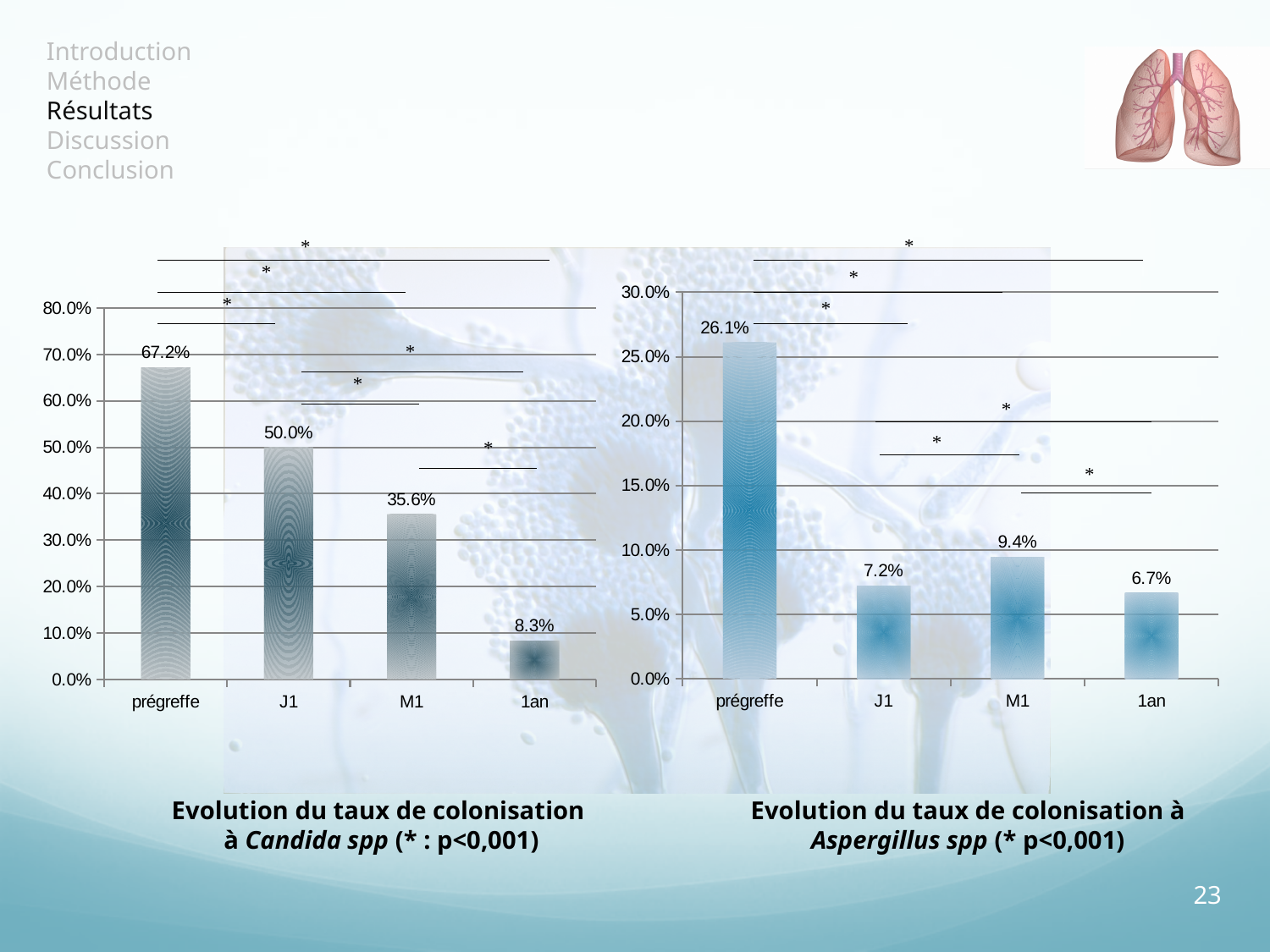
In the Aspergillus spp chart on the right, which time point has the highest colonisation rate? prégreffe How many time points are shown on the x axis of the Candida spp chart on the left? 4 In the Candida spp chart on the left, which time point has the lowest colonisation rate? 1an In the Candida spp chart on the left, what is the colonisation rate at prégreffe? 67.2% In the Candida spp chart on the left, what is the value for M1? 35.6% In the Aspergillus spp chart on the right, what is the difference between the M1 value and the 1an value? 2.7% In the Aspergillus spp chart on the right, which is larger, the value for J1 or the value for M1? M1 In the Aspergillus spp chart on the right, what is the value at 1an? 6.7% In the Aspergillus spp chart on the right, what is the value for J1? 7.2% In the Candida spp chart on the left, what is the difference between the prégreffe value and the J1 value? 17.2% What kind of chart is the Aspergillus spp chart on the right? bar chart In the Candida spp chart on the left, do the values rise or fall from prégreffe to 1an? fall